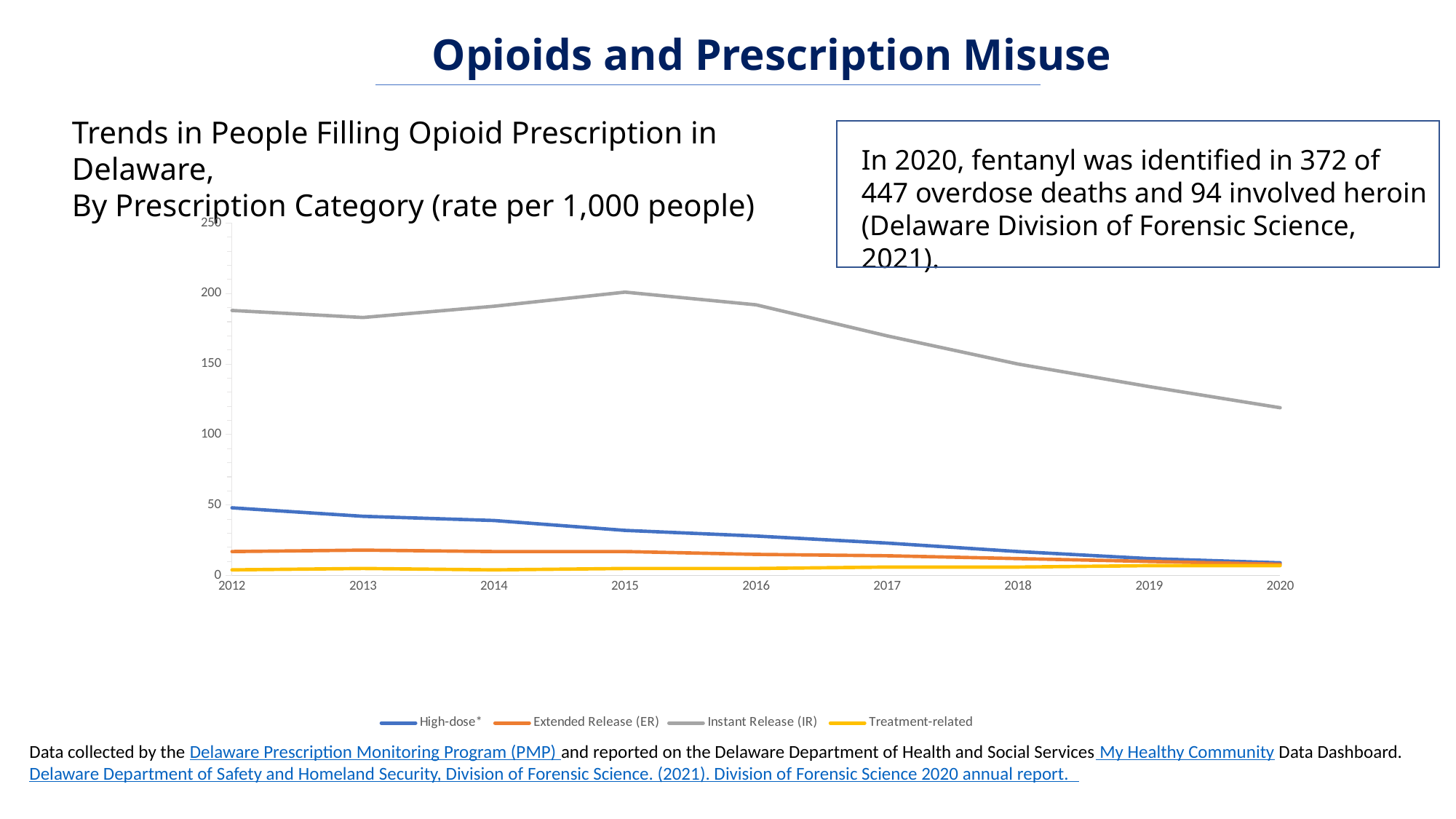
Is the value for High-dose* in 2012 greater or less than 100? less Which prescription category has the highest rate in 2012? Instant Release (IR) Is the value for Instant Release (IR) in 2015 greater or less than 150? greater How many series does the chart's legend list? 4 Does the High-dose* line rise or fall from 2012 to 2020? fall Which prescription category has the lowest rate in 2012? Treatment-related In 2015, which is larger: the Instant Release (IR) rate or the High-dose* rate? Instant Release (IR) In which year does the Instant Release (IR) line reach its highest value? 2015 Is the value for Instant Release (IR) in 2020 greater or less than 150? less What colour is the Instant Release (IR) line in the chart? grey How many years are plotted along the x axis of the chart? 9 What kind of chart is shown on the slide? line chart